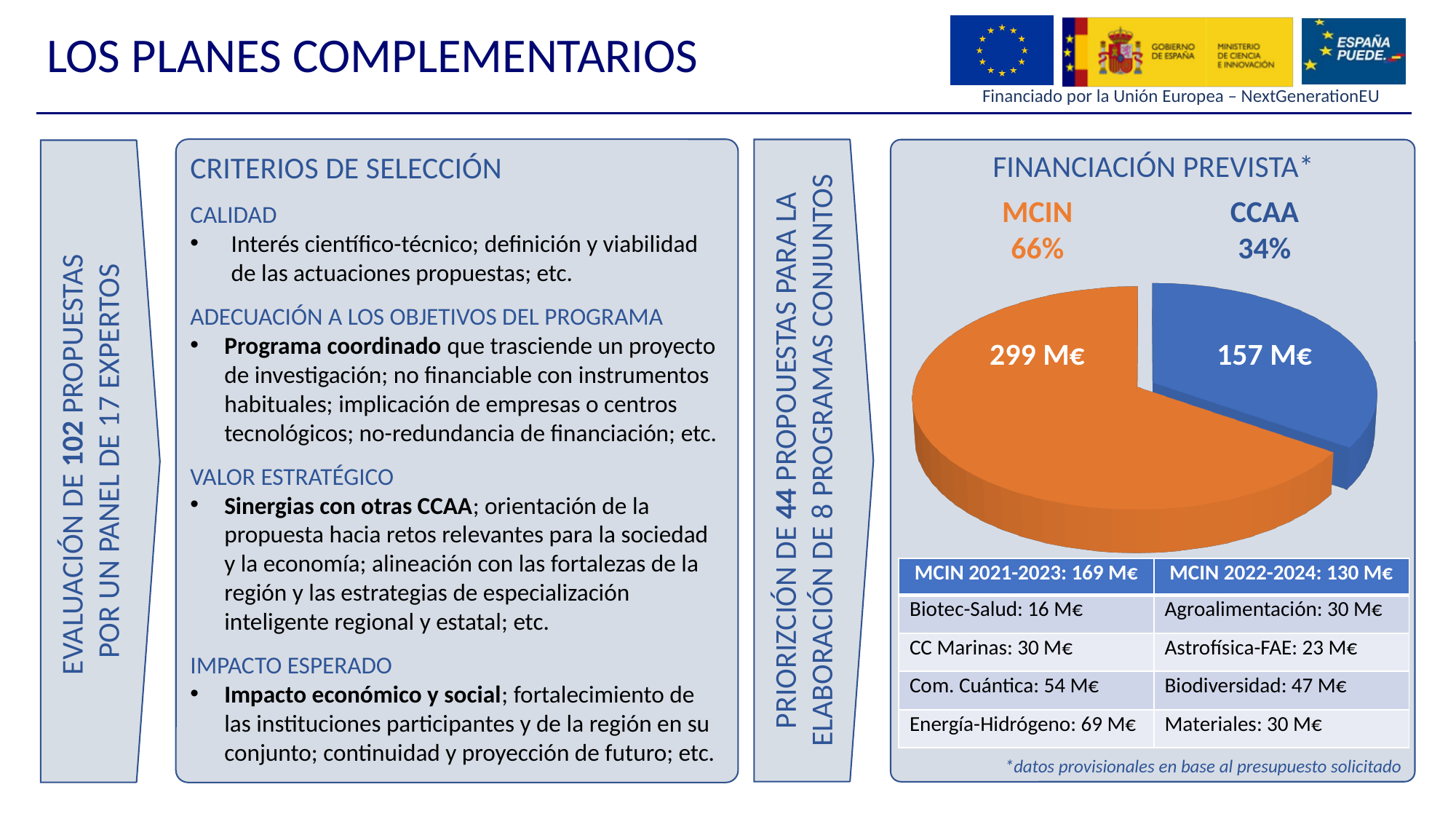
What is the value shown for CCAA in the pie chart? 157 M€ What type of chart is shown under the title FINANCIACIÓN PREVISTA? pie chart What is the value shown for MCIN in the pie chart? 299 M€ Which is larger in the pie chart, MCIN or CCAA? MCIN What percentage share of the pie does MCIN represent? 66% What is the difference between the MCIN and CCAA values in the pie chart? 142 M€ Which slice of the pie chart is the largest? MCIN How many slices does the pie chart have? 2 What is the total of the two slices in the pie chart? 456 M€ What percentage share of the pie does CCAA represent? 34% Which slice of the pie chart is the smallest? CCAA What colour is the MCIN slice in the pie chart? orange